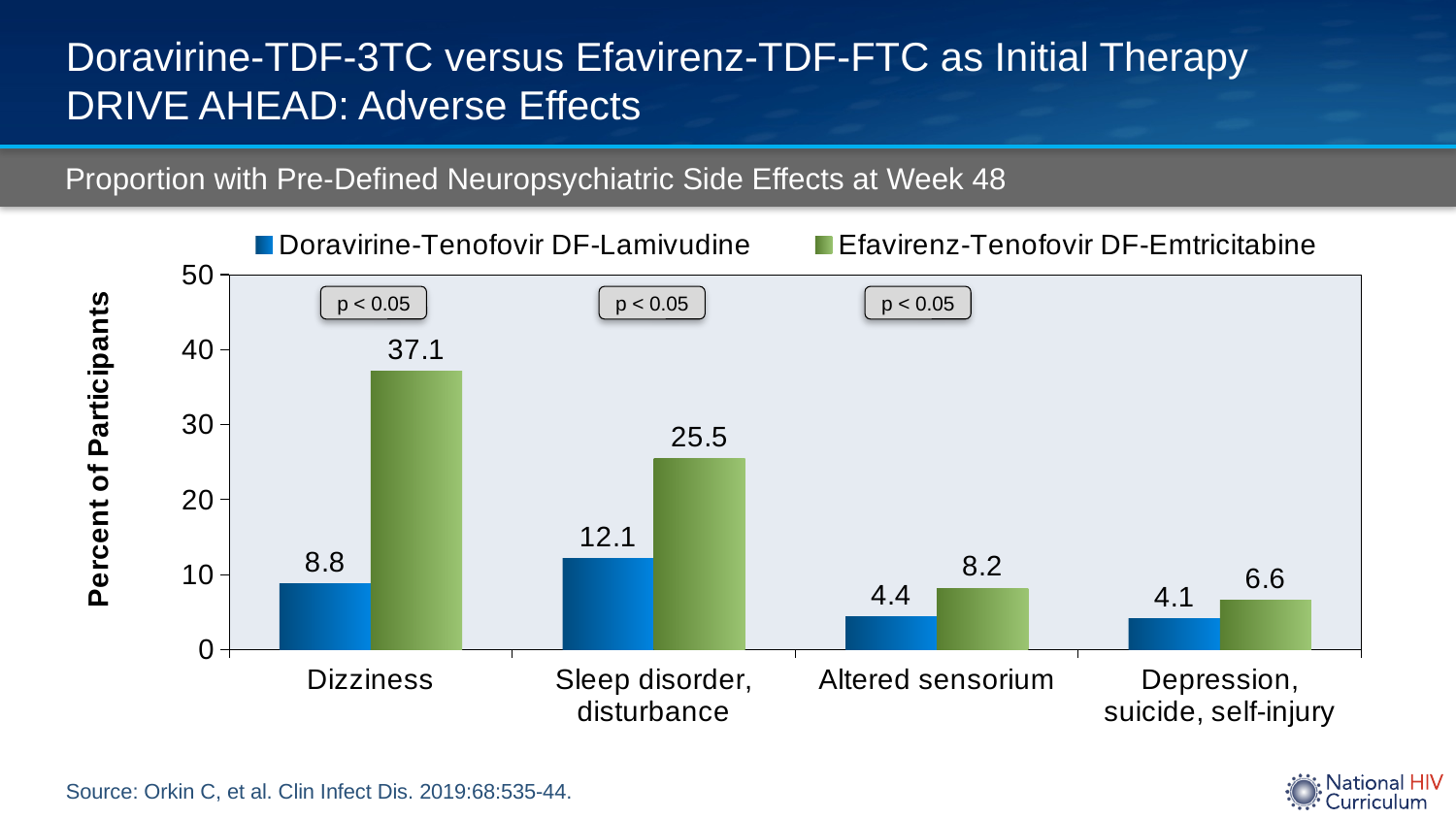
What is the difference between the Efavirenz-Tenofovir DF-Emtricitabine and Doravirine-Tenofovir DF-Lamivudine values for dizziness? 28.3 What is the value for altered sensorium in the Doravirine-Tenofovir DF-Lamivudine group? 4.4 What percentage of participants on Efavirenz-Tenofovir DF-Emtricitabine reported sleep disorder, disturbance? 25.5 For depression, suicide, self-injury, which group has the larger value? Efavirenz-Tenofovir DF-Emtricitabine What kind of chart is shown on the slide? Bar chart How many series does the legend list? 2 Which side effect category has the highest value for the Efavirenz-Tenofovir DF-Emtricitabine group? Dizziness What percentage of participants on Doravirine-Tenofovir DF-Lamivudine reported dizziness? 8.8 Is the value for sleep disorder, disturbance in the Efavirenz-Tenofovir DF-Emtricitabine group greater or less than 20? greater What is the label of the y axis? Percent of Participants How many side effect categories are shown on the x axis? 4 Which side effect category has the lowest value for the Doravirine-Tenofovir DF-Lamivudine group? Depression, suicide, self-injury